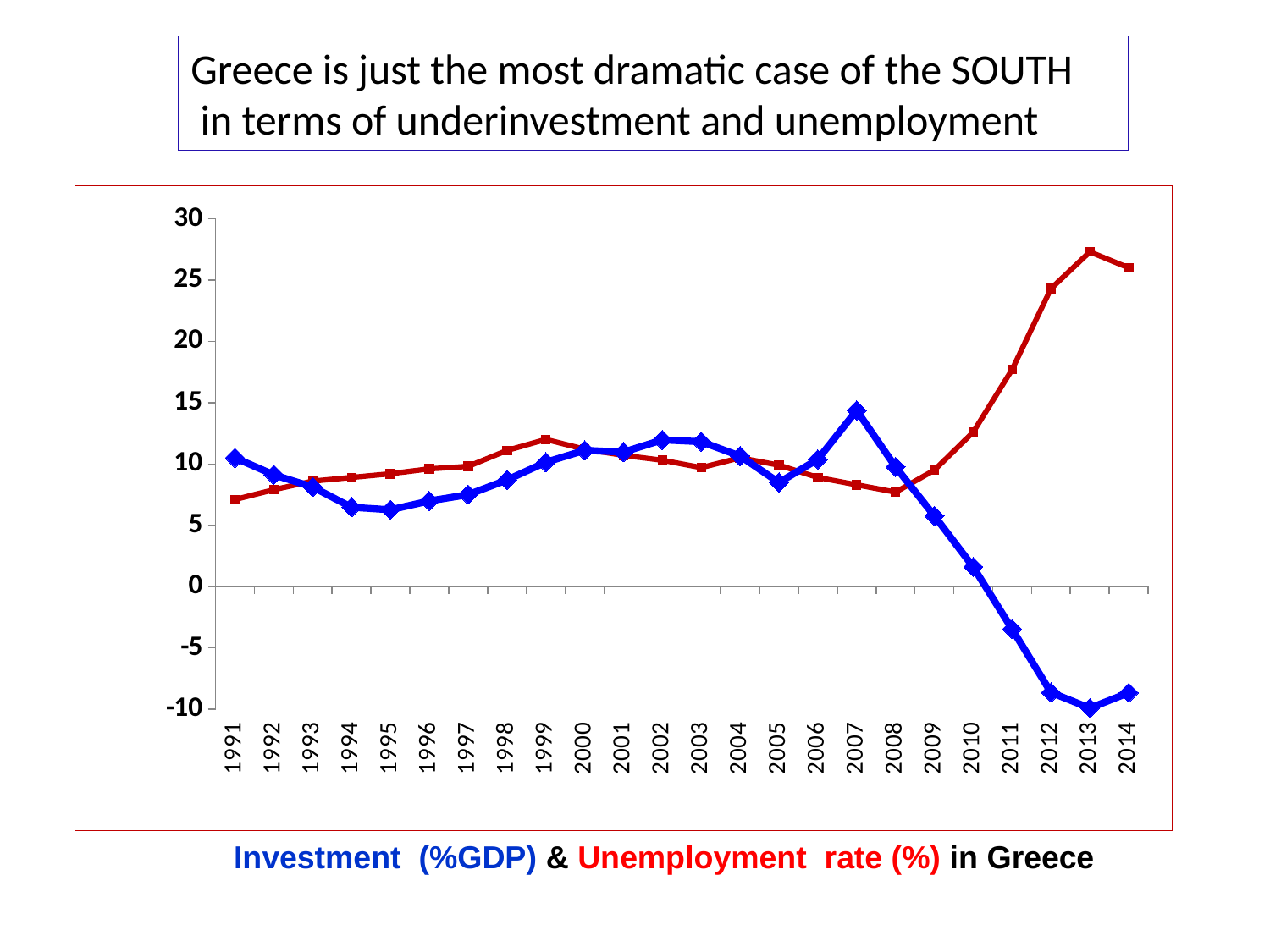
What kind of chart is shown on the slide? line chart Is the Unemployment rate (%) value for 2011 greater or less than 15? greater Is the Unemployment rate (%) value for 2013 greater or less than 25? greater How many years are plotted along the x axis of the chart? 24 What colour is the Investment (%GDP) line in the chart? blue In which year does the Investment (%GDP) series reach its highest value? 2007 In which year does the Investment (%GDP) series reach its lowest value? 2013 How many series does the chart plot? 2 Does the Unemployment rate (%) series rise or fall between 2008 and 2013? rise In which year does the Unemployment rate (%) series reach its highest value? 2013 In 2014, which is larger: Investment (%GDP) or Unemployment rate (%)? Unemployment rate (%) Is the Investment (%GDP) value for 2013 greater or less than -5? less